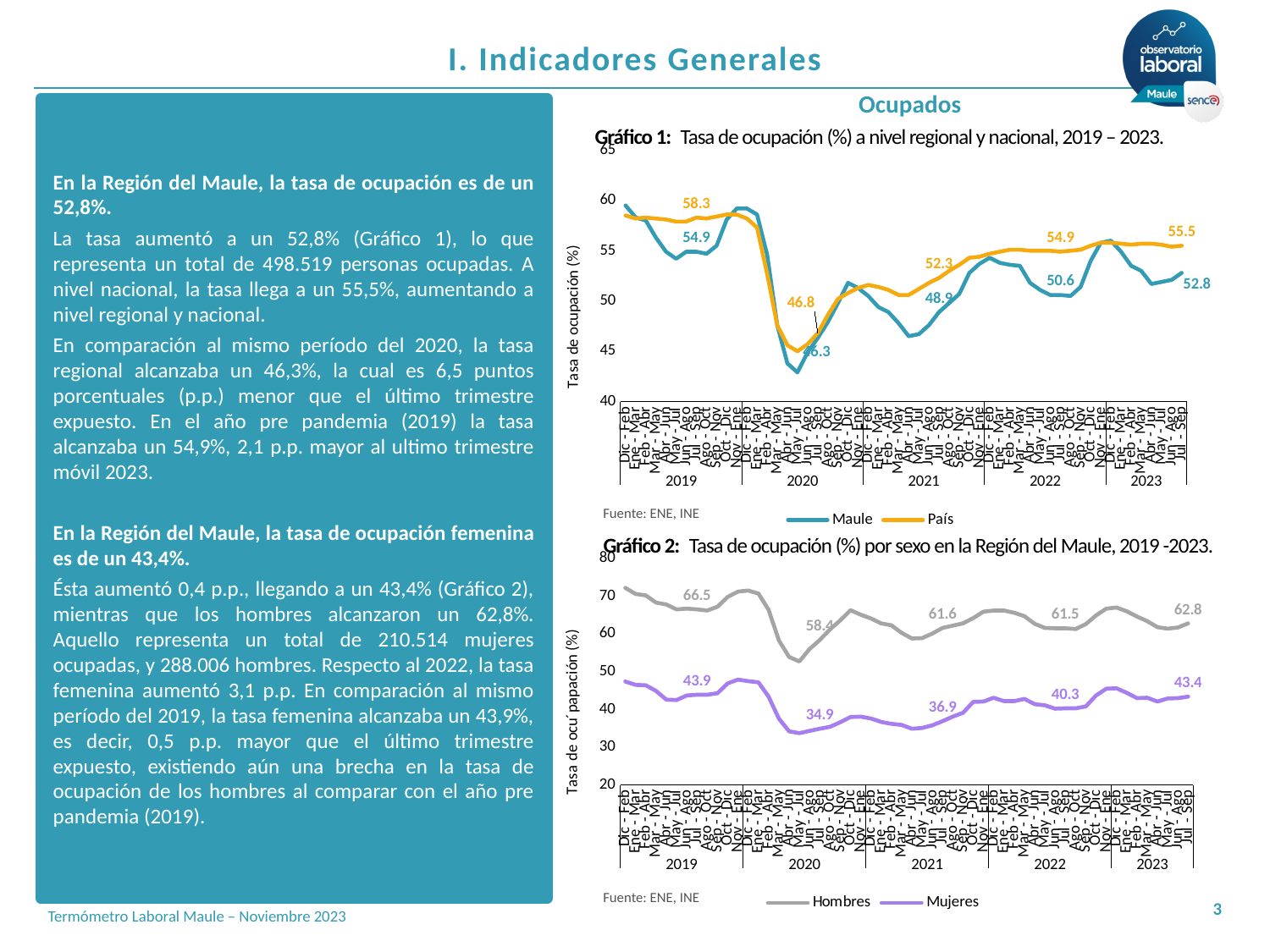
In Gráfico 2, is the Hombres series ever below 50 on the y axis? No In Gráfico 1, what is the last labelled value for the Maule series? 52.8 What kind of chart is Gráfico 2? Line chart In Gráfico 2, what is the last labelled value for the Mujeres series? 43.4 In Gráfico 1, which series is higher at the end of the period, Maule or País? País In Gráfico 1, what is the last labelled value for the País series? 55.5 In Gráfico 2, what is the difference between the final labelled Hombres value (62.8) and the final labelled Mujeres value (43.4)? 19.4 In Gráfico 1, what is the difference between the final labelled País value (55.5) and the final labelled Maule value (52.8)? 2.7 In Gráfico 2, which colour is used for the Mujeres series? Purple In Gráfico 2, what is the last labelled value for the Hombres series? 62.8 How many series does the legend of Gráfico 1 list? 2 In Gráfico 2, what is the lowest labelled value on the Mujeres series? 34.9